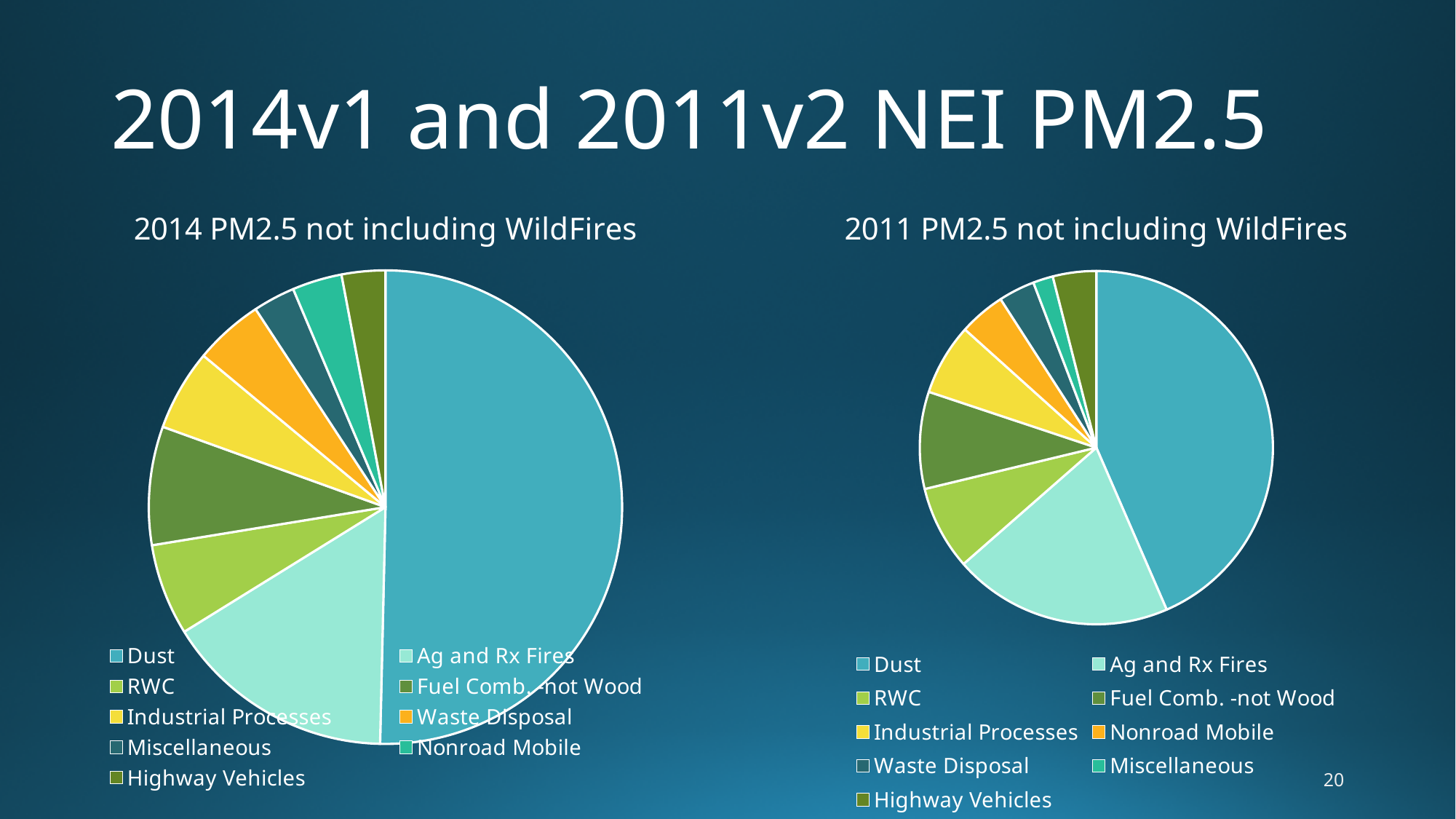
In the '2011 PM2.5 not including WildFires' chart, which is larger, Ag and Rx Fires or RWC? Ag and Rx Fires In the '2014 PM2.5 not including WildFires' chart, which is larger, Dust or Ag and Rx Fires? Dust What kind of chart is the '2014 PM2.5 not including WildFires' chart? pie chart What kind of chart is the '2011 PM2.5 not including WildFires' chart? pie chart In the '2011 PM2.5 not including WildFires' chart, which category has the largest slice? Dust In the '2011 PM2.5 not including WildFires' chart, how many slices does the pie have? 9 In the '2014 PM2.5 not including WildFires' chart, which category is shown in orange according to the legend? Waste Disposal In the '2011 PM2.5 not including WildFires' chart, which category has the smallest slice? Miscellaneous In the '2014 PM2.5 not including WildFires' chart, which category has the largest slice? Dust What is the title of the pie chart on the left of the slide? 2014 PM2.5 not including WildFires In the '2014 PM2.5 not including WildFires' chart, how many categories does the legend list? 9 In the '2014 PM2.5 not including WildFires' chart, which is larger, RWC or Waste Disposal? RWC